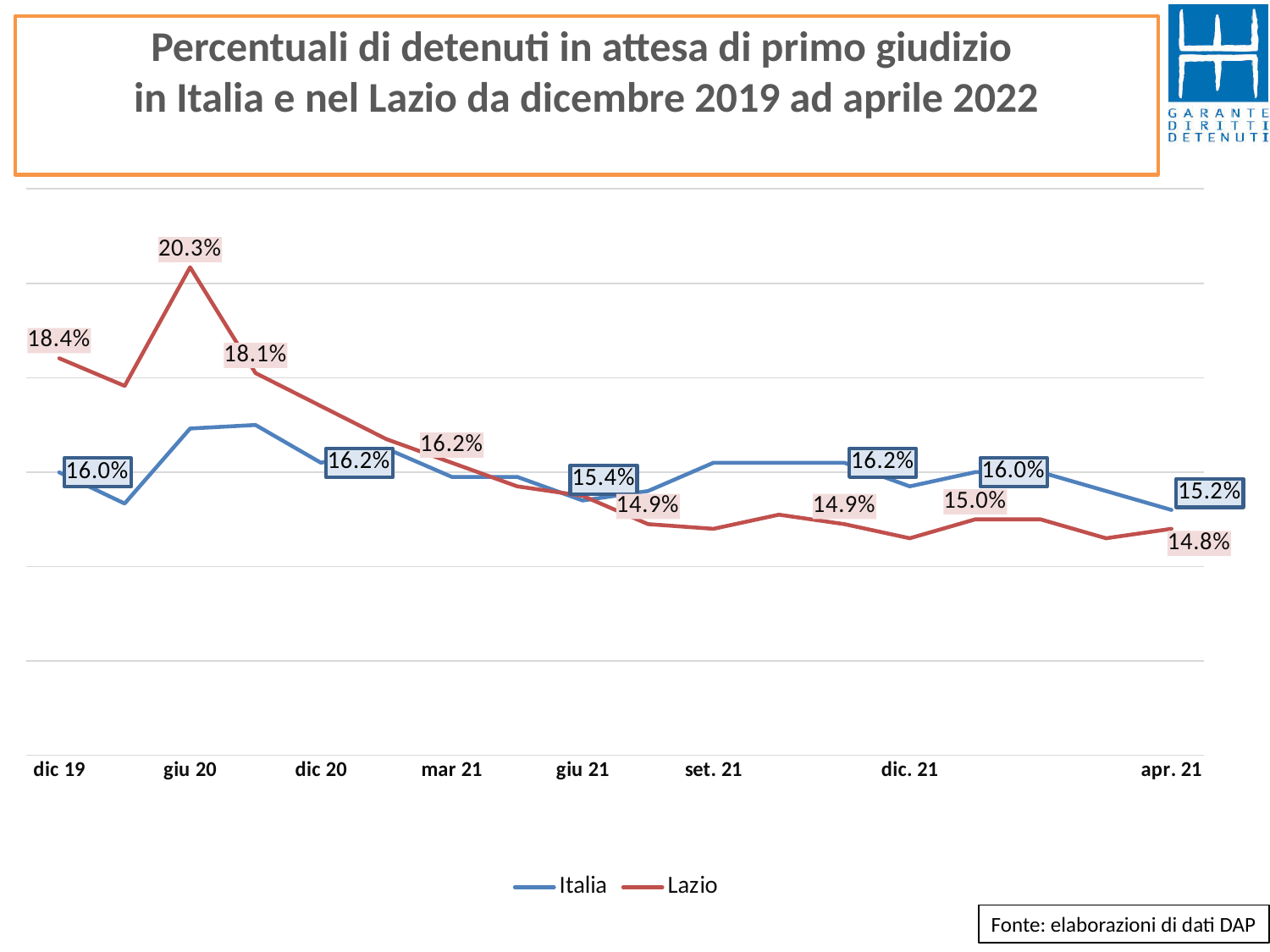
What is the difference between the Lazio values at giu 20 and dic 19? 1.9 percentage points What is the difference between the Lazio and Italia values at dic 19? 2.4 percentage points What is the value for Lazio at apr. 21? 14.8% What is the value for Lazio at dic 19? 18.4% What is the value for Italia at apr. 21? 15.2% What kind of chart is shown on the slide? Line chart At which x-axis point does Lazio reach its highest value? giu 20 How many series does the legend list? 2 What is the value for Italia at giu 21? 15.4% What is the value for Italia at dic 19? 16.0% Which series has the higher value at apr. 21, Italia or Lazio? Italia What is the value for Lazio at giu 20? 20.3%